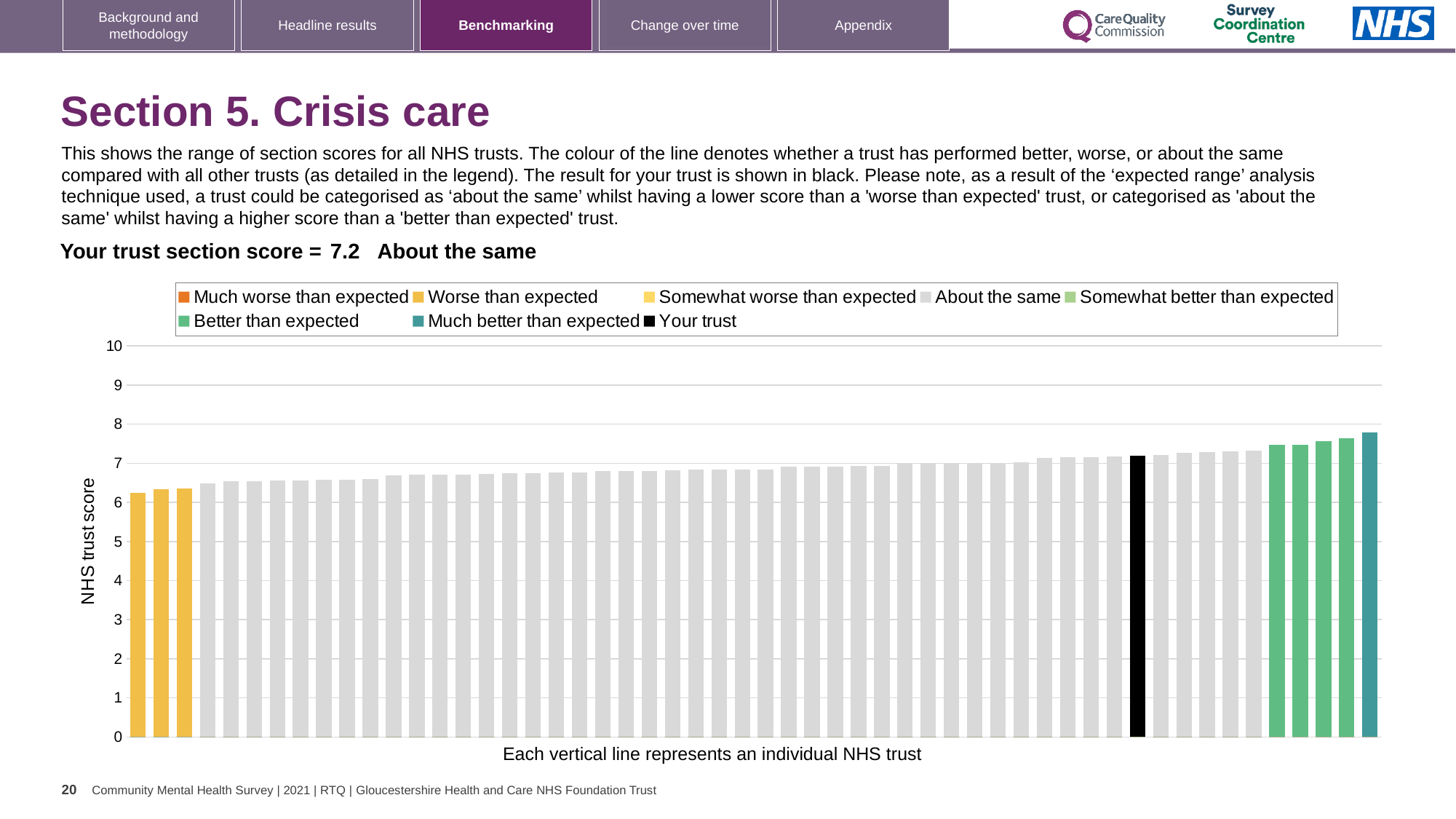
Which category is your trust's section score placed in? About the same How many entries does the chart legend list? 8 Is the value of the black 'Your trust' bar greater or less than 5? greater How many yellow bars are shown at the left of the chart? 3 What is the label on the vertical axis of the chart? NHS trust score What is the section score for your trust shown on the slide? 7.2 What kind of chart is shown on the slide? bar chart How many teal 'Much better than expected' bars are shown on the chart? 1 Is the value of the leftmost (lowest) bar greater or less than 7? less Which is taller: the black 'Your trust' bar or the rightmost teal bar? the rightmost teal bar Is the value of the rightmost (highest) bar greater or less than 7? greater Do the bar heights rise or fall from left to right across the chart? rise